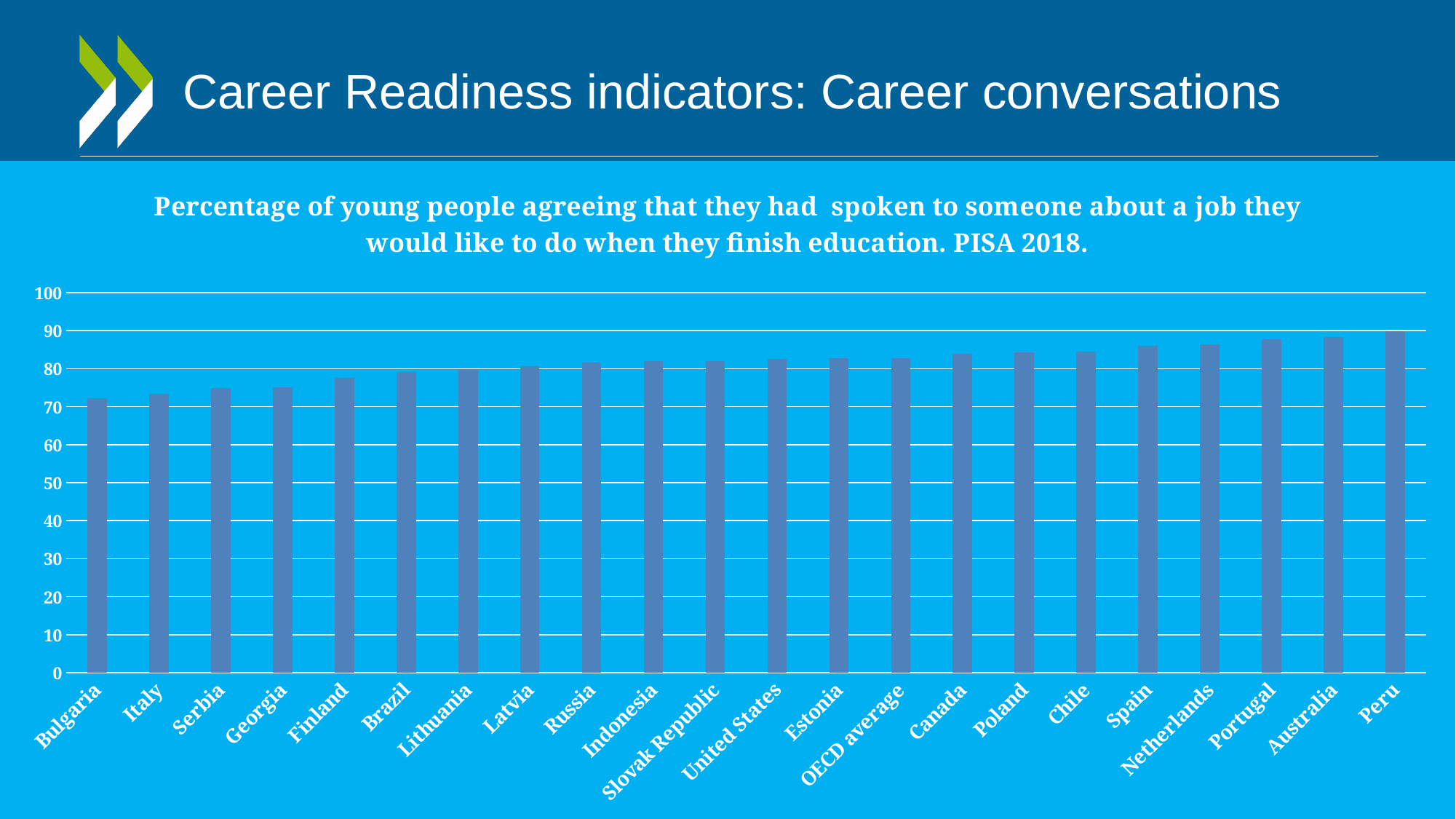
Is the value for Finland greater or less than 80? less Is the value for Bulgaria greater or less than 80? less What kind of chart is shown on the slide? bar chart Do the values generally rise or fall moving from left to right along the x axis? rise What is the highest value shown on the vertical axis of the chart? 100 Is the value for Peru greater or less than 80? greater Which has a larger value, Serbia or Netherlands? Netherlands How many countries or categories are shown on the x axis of the chart? 22 Which has a larger value, Peru or Bulgaria? Peru Which category has the highest value in the chart? Peru